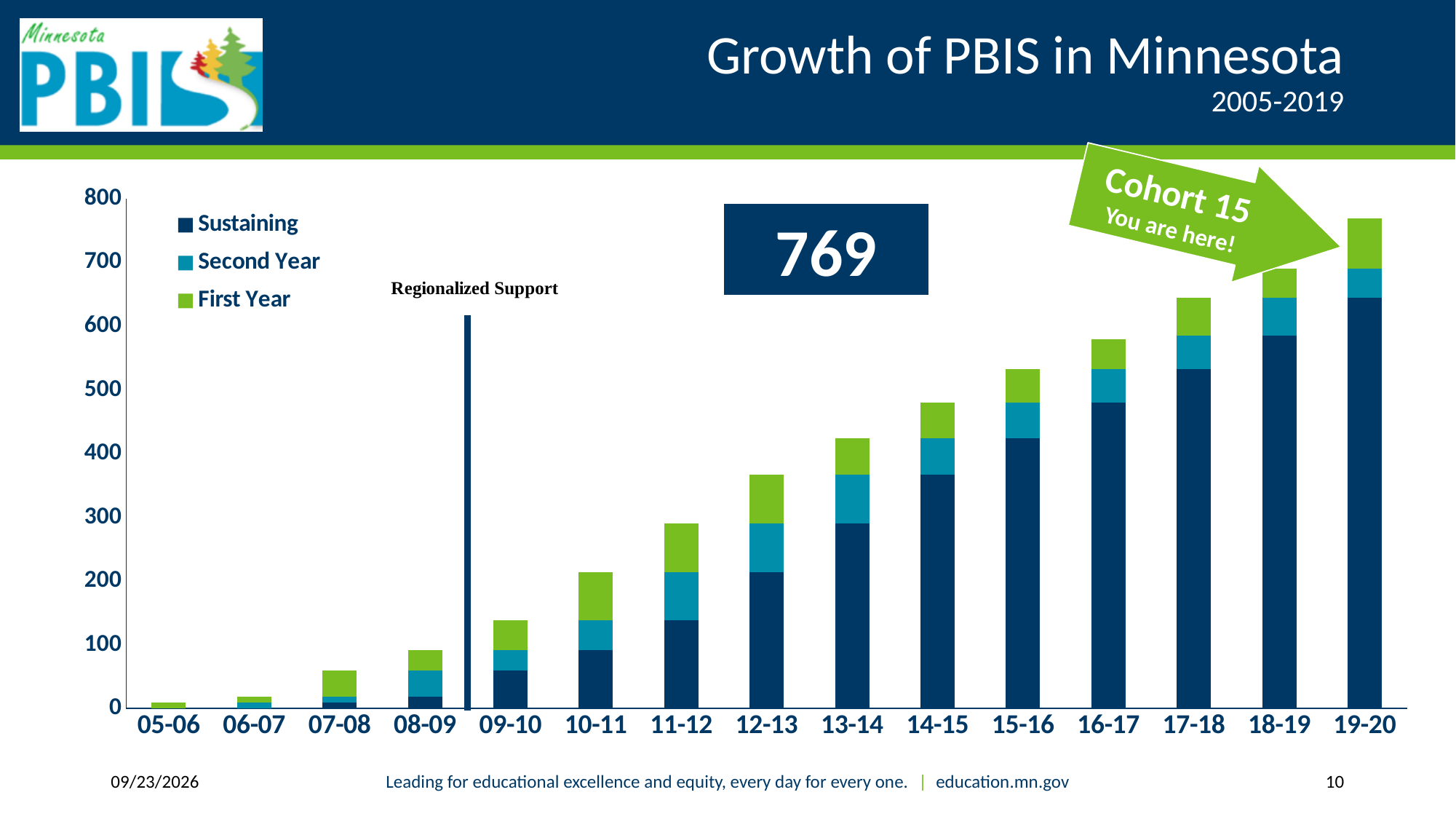
Do the total bar heights rise or fall from 05-06 to 19-20? Rise What kind of chart is shown on the slide? Stacked bar chart Which school year has the tallest total bar? 19-20 Is the total bar for 13-14 greater or less than 400? greater What number is displayed in the dark box above the chart? 769 How many school-year categories are shown on the x axis? 15 Which has the larger total bar, 12-13 or 17-18? 17-18 Is the total bar for 08-09 greater or less than 100? less Is the total bar for 19-20 greater or less than 700? greater Which school year has the shortest total bar? 05-06 How many series does the legend list? 3